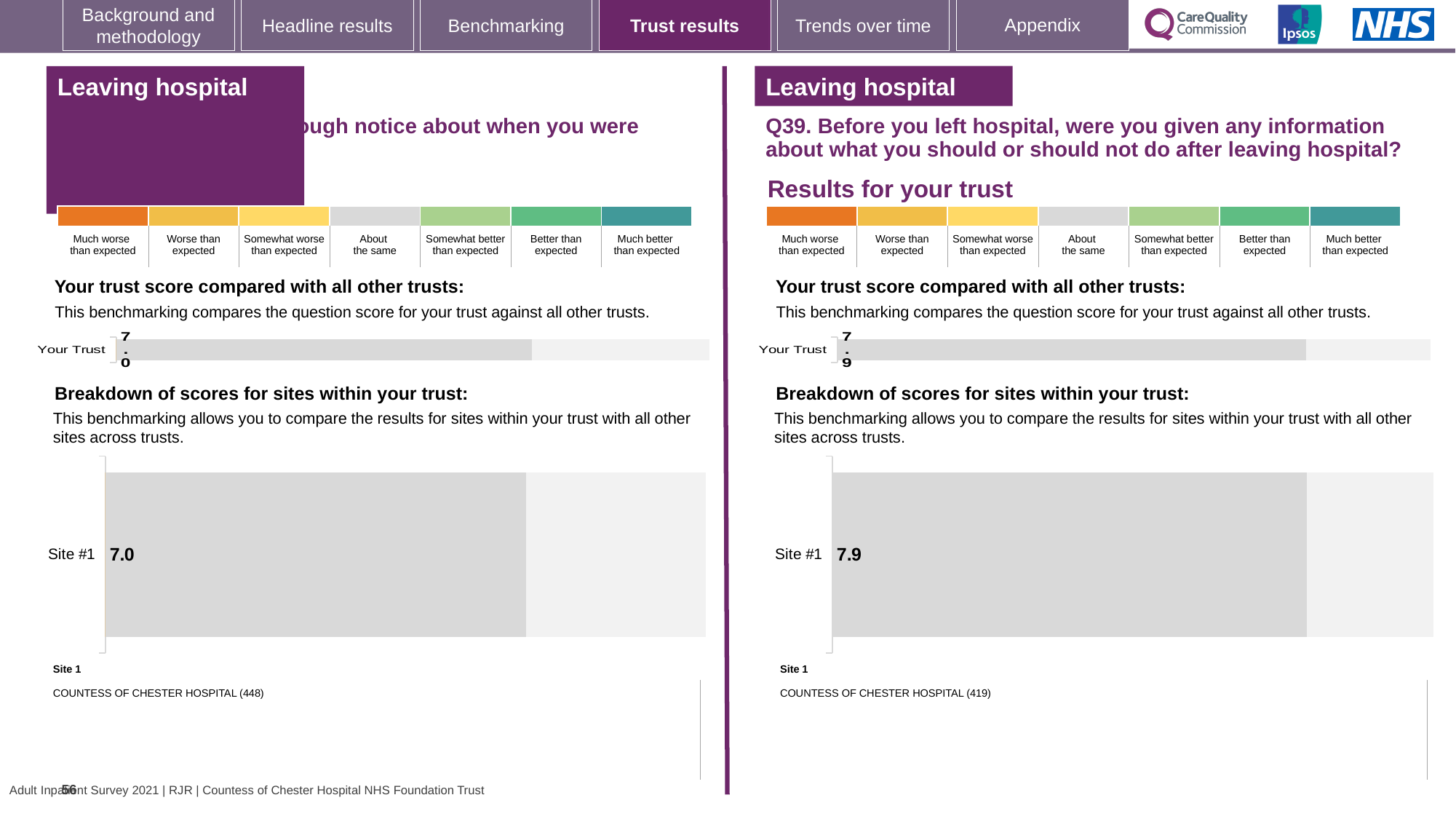
In the right-hand (Q39) 'Your trust score compared with all other trusts' chart, what is the label of the single bar? Your Trust On the right half of the slide (Q39), in the 'Your trust score compared with all other trusts' chart, what is the value for Your Trust? 7.9 How many sites are plotted in the 'Breakdown of scores for sites within your trust' chart on the right half of the slide (Q39)? 1 On the right half of the slide (Q39), in the 'Breakdown of scores for sites within your trust' chart, what is the value for Site #1? 7.9 On the left half of the slide, in the 'Breakdown of scores for sites within your trust' chart, what is the value for Site #1? 7.0 What kind of chart is used to show the Site #1 score in the 'Breakdown of scores for sites within your trust' section on the right half of the slide? Bar chart On the left half of the slide, in the 'Your trust score compared with all other trusts' chart, what is the value for Your Trust? 7.0 Which is larger: the Site #1 score in the left-hand breakdown chart or the Site #1 score in the right-hand (Q39) breakdown chart? The right-hand (Q39) chart Which hospital is listed as Site 1 beneath the breakdown chart on the right half of the slide (Q39)? COUNTESS OF CHESTER HOSPITAL (419) How many sites are plotted in the 'Breakdown of scores for sites within your trust' chart on the left half of the slide? 1 What is the difference between the Site #1 score in the right-hand (Q39) breakdown chart and the Site #1 score in the left-hand breakdown chart? 0.9